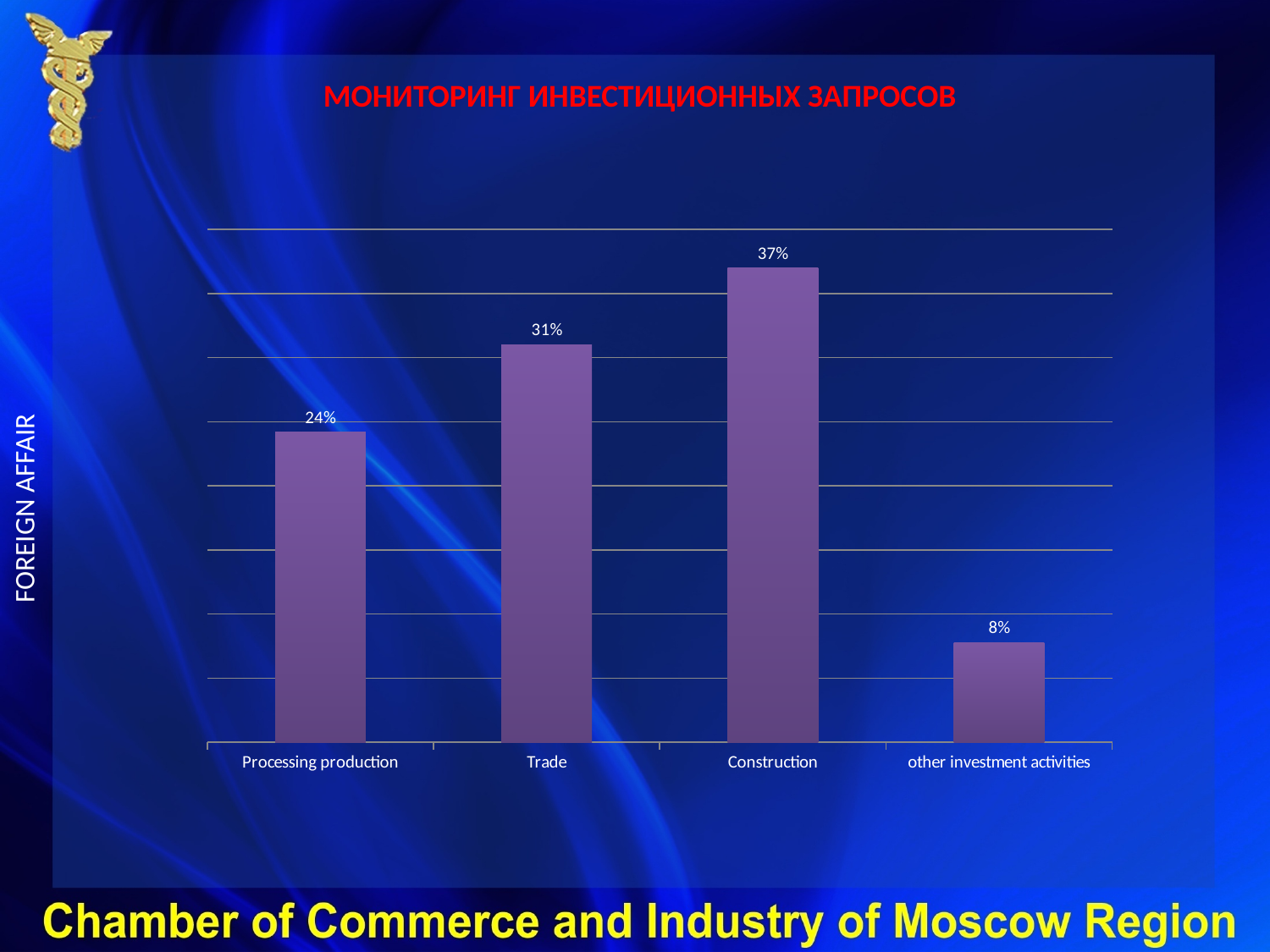
How many categories are shown on the x axis? 4 What is the difference between the values for Processing production and other investment activities? 16% What is the difference between the values for Construction and Trade? 6% Which category has the lowest value? other investment activities What kind of chart is shown on the slide? Bar chart Which category has the highest value? Construction What is the value for other investment activities? 8% What is the value for Processing production? 24% What is the value for Construction? 37% What is the title of the chart? МОНИТОРИНГ ИНВЕСТИЦИОННЫХ ЗАПРОСОВ Which is larger, the value for Trade or the value for Processing production? Trade What is the value for Trade? 31%